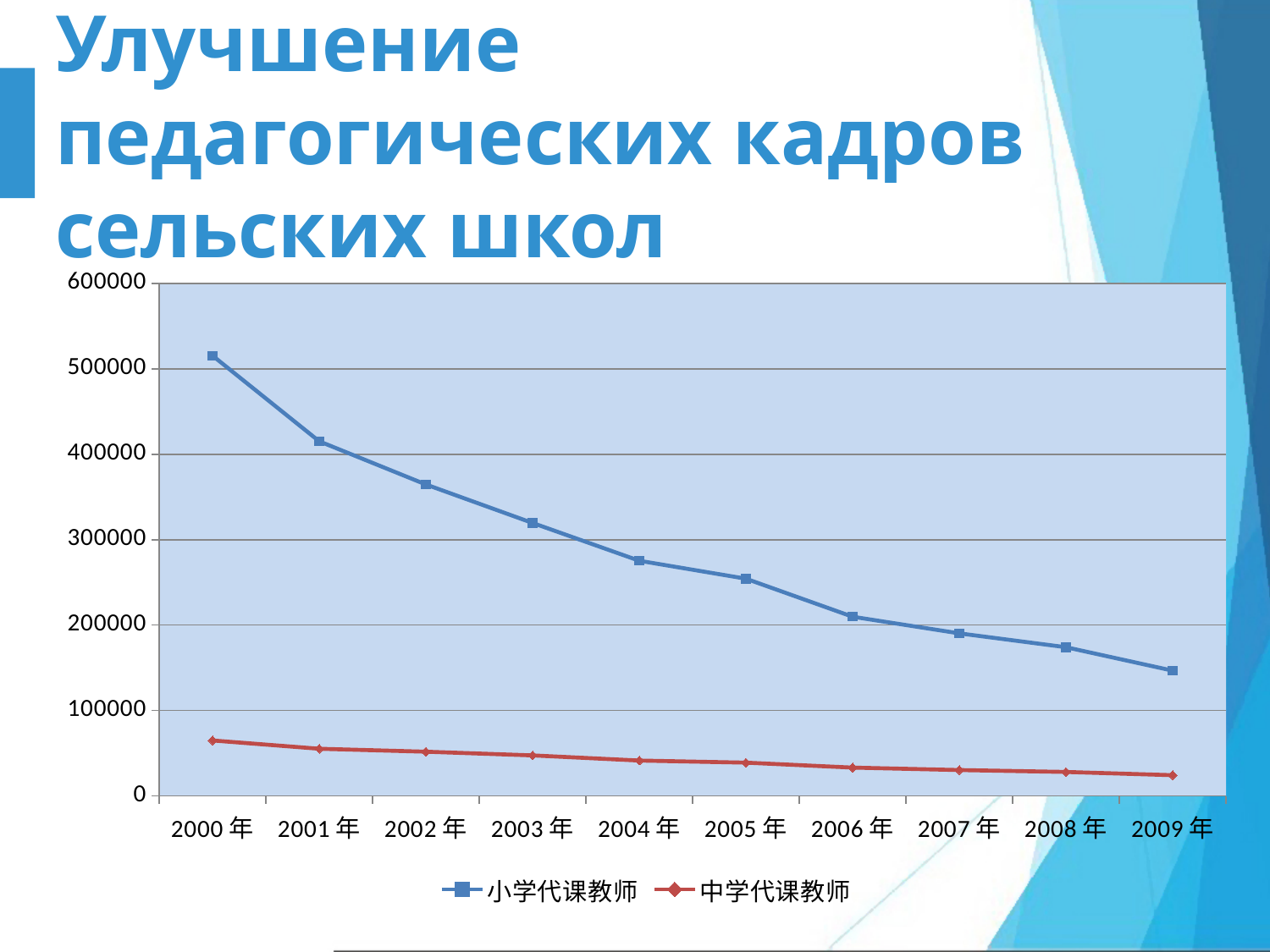
Is the value for 小学代课教师 in 2009年 greater or less than 200000? less Do the values for 小学代课教师 rise or fall from 2000年 to 2009年? fall How many years are plotted along the x axis? 10 Is the value for 中学代课教师 in 2000年 greater or less than 100000? less Do the values for 中学代课教师 rise or fall from 2000年 to 2009年? fall Which series has the larger value in 2005年, 小学代课教师 or 中学代课教师? 小学代课教师 Is the value for 小学代课教师 in 2001年 greater or less than 400000? greater How many series does the legend list? 2 What kind of chart is shown on the slide? line chart In which year is the value for 小学代课教师 lowest? 2009年 In which year is the value for 小学代课教师 highest? 2000年